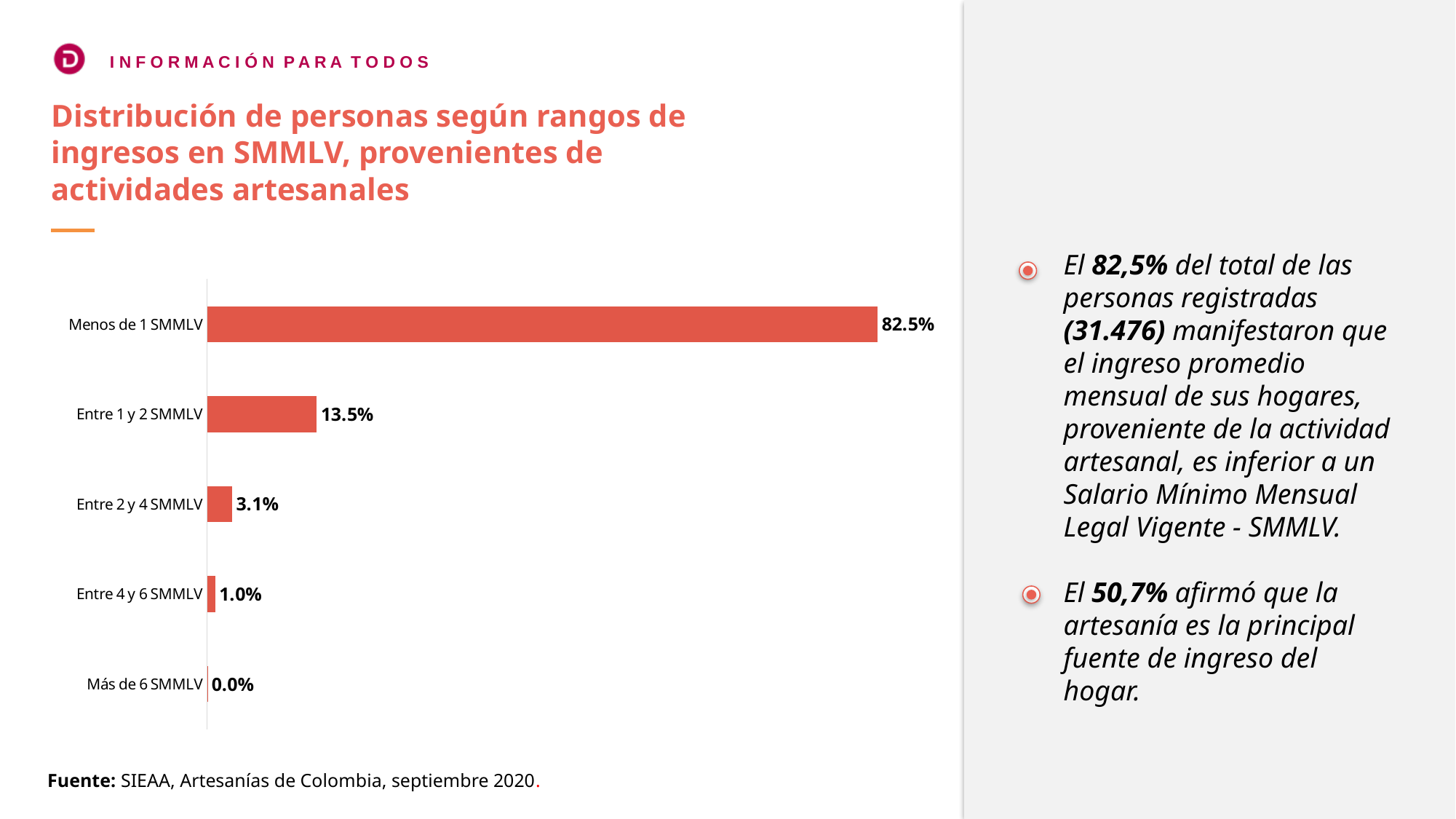
What is the value for 'Entre 1 y 2 SMMLV'? 13.5% What is the difference between the values for 'Menos de 1 SMMLV' and 'Entre 1 y 2 SMMLV'? 69.0% What kind of chart is shown on the slide? Bar chart What is the value for 'Entre 2 y 4 SMMLV'? 3.1% Which category has the lowest value? Más de 6 SMMLV What is the value for 'Entre 4 y 6 SMMLV'? 1.0% Which is larger, the value for 'Entre 2 y 4 SMMLV' or 'Entre 4 y 6 SMMLV'? Entre 2 y 4 SMMLV What is the value for 'Menos de 1 SMMLV'? 82.5% Which category has the highest value? Menos de 1 SMMLV What is the source cited below the chart? SIEAA, Artesanías de Colombia, septiembre 2020 What is the value for 'Más de 6 SMMLV'? 0.0% How many categories are shown in the chart? 5